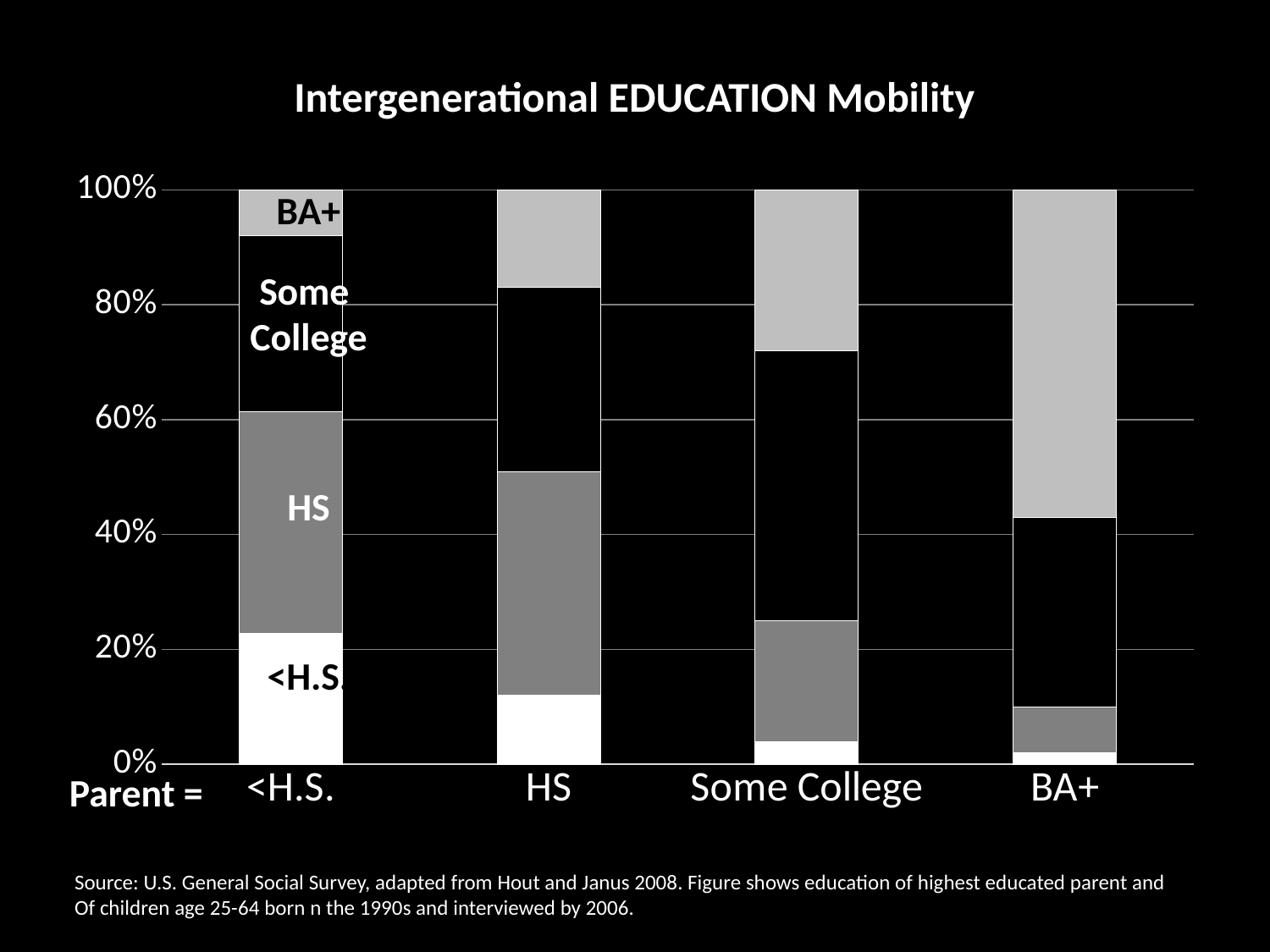
Which child education level is shown by the light gray segment at the top of each bar? BA+ What kind of chart is shown on the slide? Stacked bar chart Is the BA+ share for children of BA+ parents greater or less than 40%? greater How many parent education categories are shown along the x axis? 4 Which parent category has the smallest <H.S. share among children? BA+ Is the <H.S. share for children of HS parents greater or less than 20%? less What is the title of the chart? Intergenerational EDUCATION Mobility Does the BA+ share of children rise or fall as parent education increases from <H.S. to BA+? rise How many child education levels (segments) make up each stacked bar? 4 Which is larger: the HS share for children of <H.S. parents or the HS share for children of BA+ parents? <H.S. parents Which parent category has the largest BA+ share among children? BA+ Is the BA+ share for children of <H.S. parents greater or less than 20%? less